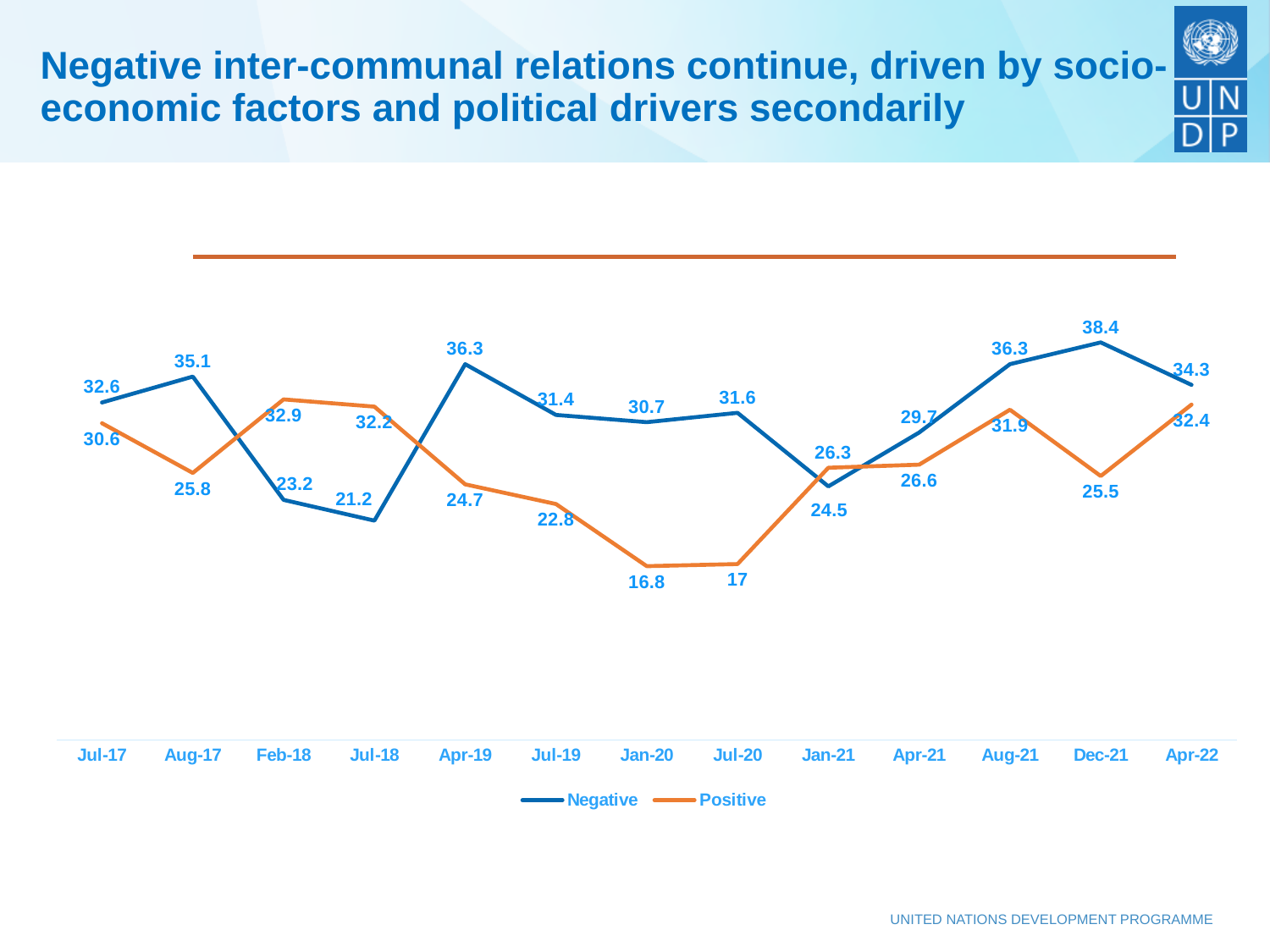
How many time points are plotted along the x axis? 13 How many series does the legend list? 2 In which period does the Negative series reach its lowest value? Jul-18 What is the value of the Negative series in Dec-21? 38.4 In which period does the Negative series reach its highest value? Dec-21 In which period does the Positive series reach its lowest value? Jan-20 Does the Negative series rise or fall from Jan-21 to Dec-21? Rise What is the value of the Negative series in Jul-18? 21.2 What type of chart is shown on the slide? Line chart What is the difference between the Negative and Positive values in Dec-21? 12.9 What is the value of the Positive series in Jan-20? 16.8 In Feb-18, which series has the larger value, Negative or Positive? Positive